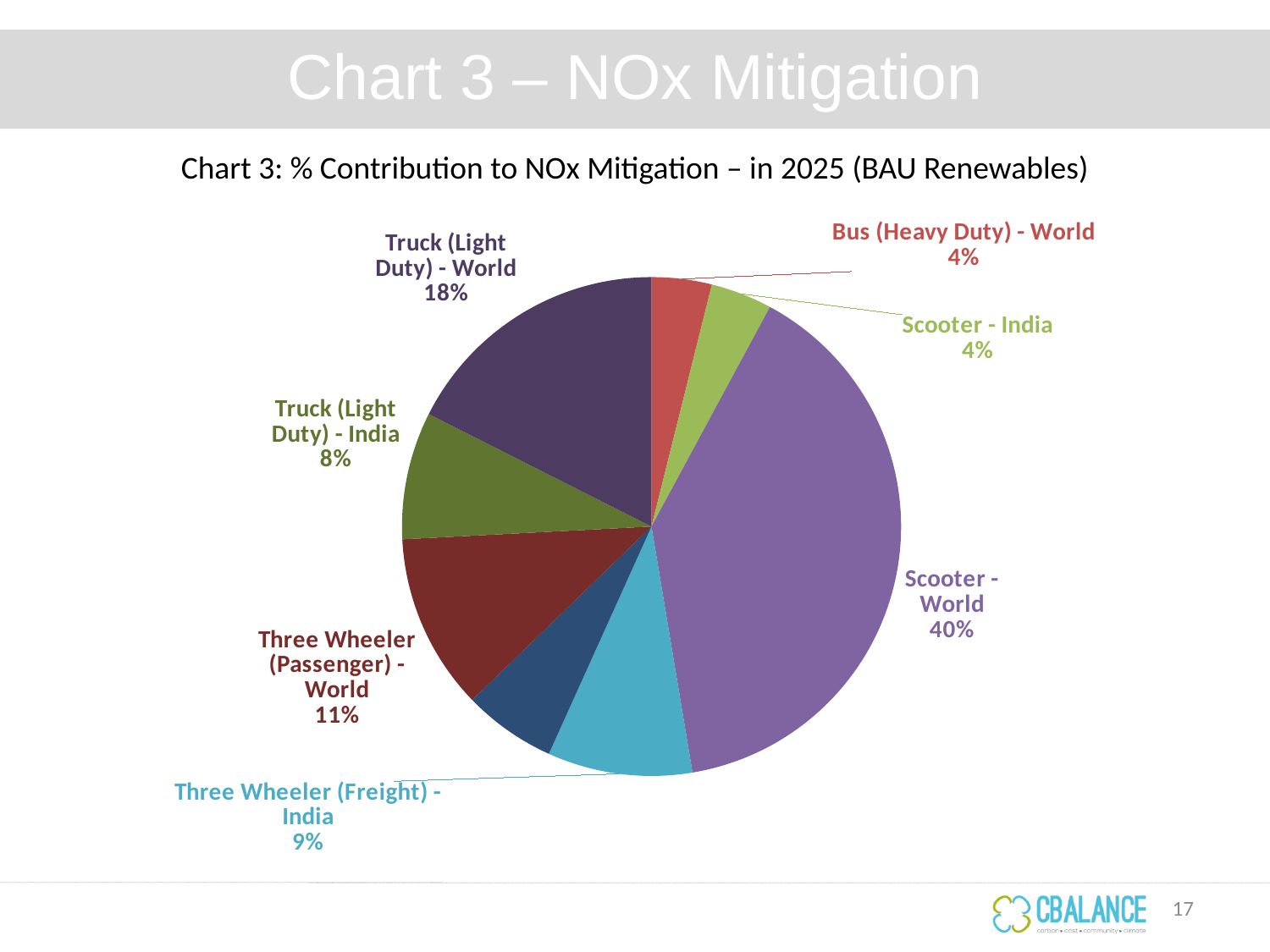
What is the difference in percentage points between Truck (Light Duty) - World and Truck (Light Duty) - India? 10 percentage points What is the title of the chart? Chart 3: % Contribution to NOx Mitigation – in 2025 (BAU Renewables) What type of chart is shown on the slide? Pie chart What is the percentage contribution of Bus (Heavy Duty) - World? 4% What share of the pie does Scooter - World represent? 40% What is the percentage contribution of Truck (Light Duty) - India? 8% Which has a larger share: Three Wheeler (Passenger) - World or Three Wheeler (Freight) - India? Three Wheeler (Passenger) - World What is the percentage contribution of Truck (Light Duty) - World? 18% Which category has the largest share of NOx mitigation? Scooter - World What is the percentage contribution of Three Wheeler (Passenger) - World? 11% What is the percentage contribution of Three Wheeler (Freight) - India? 9% What is the percentage contribution of Scooter - World to NOx mitigation? 40%